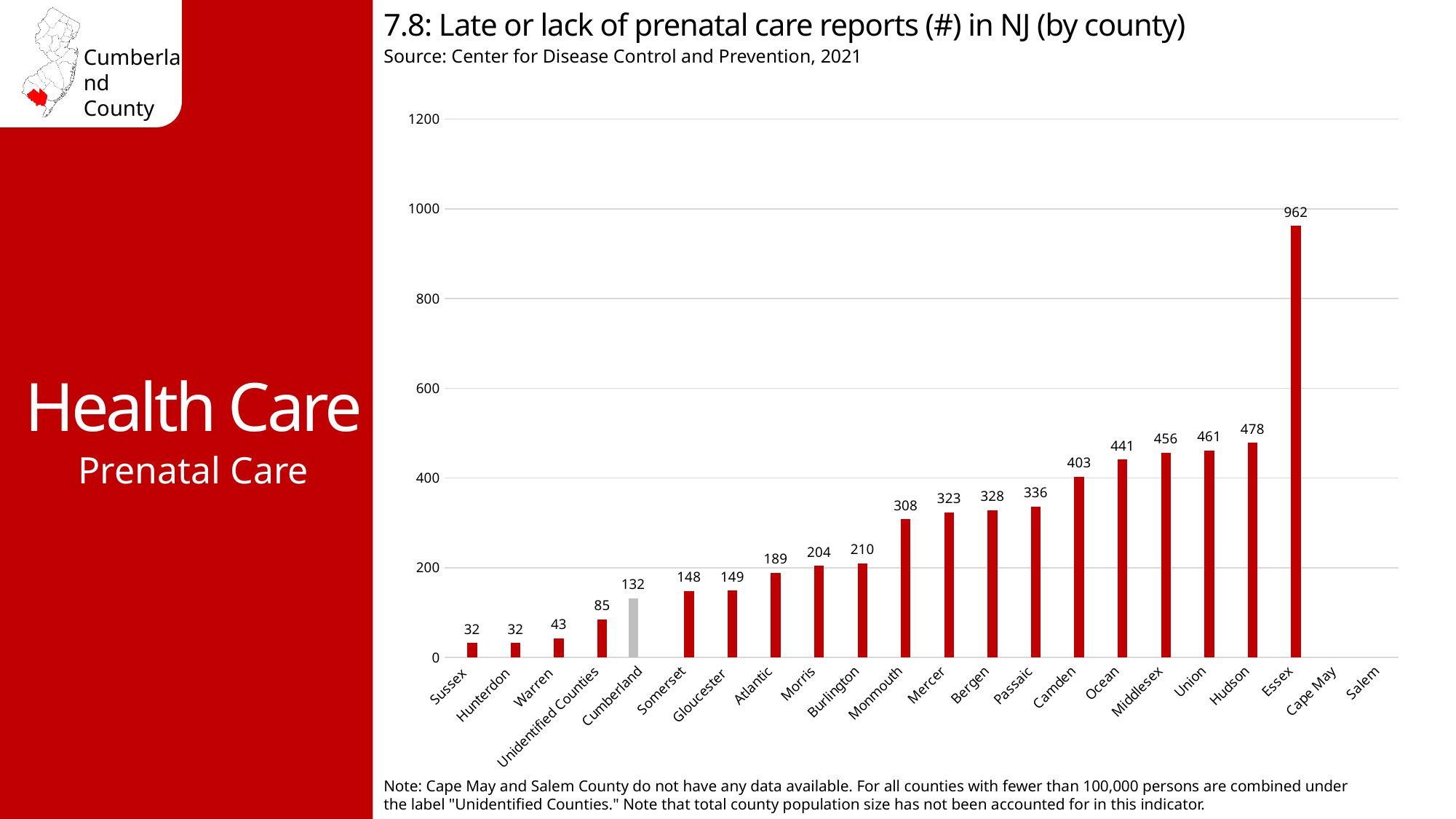
What is the difference between the values for Essex and Hudson? 484 What is the value for Cumberland? 132 What kind of chart is shown on the slide? Bar chart How many categories are labelled on the x axis? 22 Which is larger, the value for Warren or the value for Unidentified Counties? Unidentified Counties Which county's bar is coloured grey instead of red? Cumberland Which is larger, the value for Camden or the value for Ocean? Ocean What is the value for Essex? 962 What is the value for Monmouth? 308 Which county has the highest number of late or lack of prenatal care reports? Essex What is the difference between the values for Cumberland and Somerset? 16 Do the values generally rise or fall from Sussex to Essex along the x axis? Rise